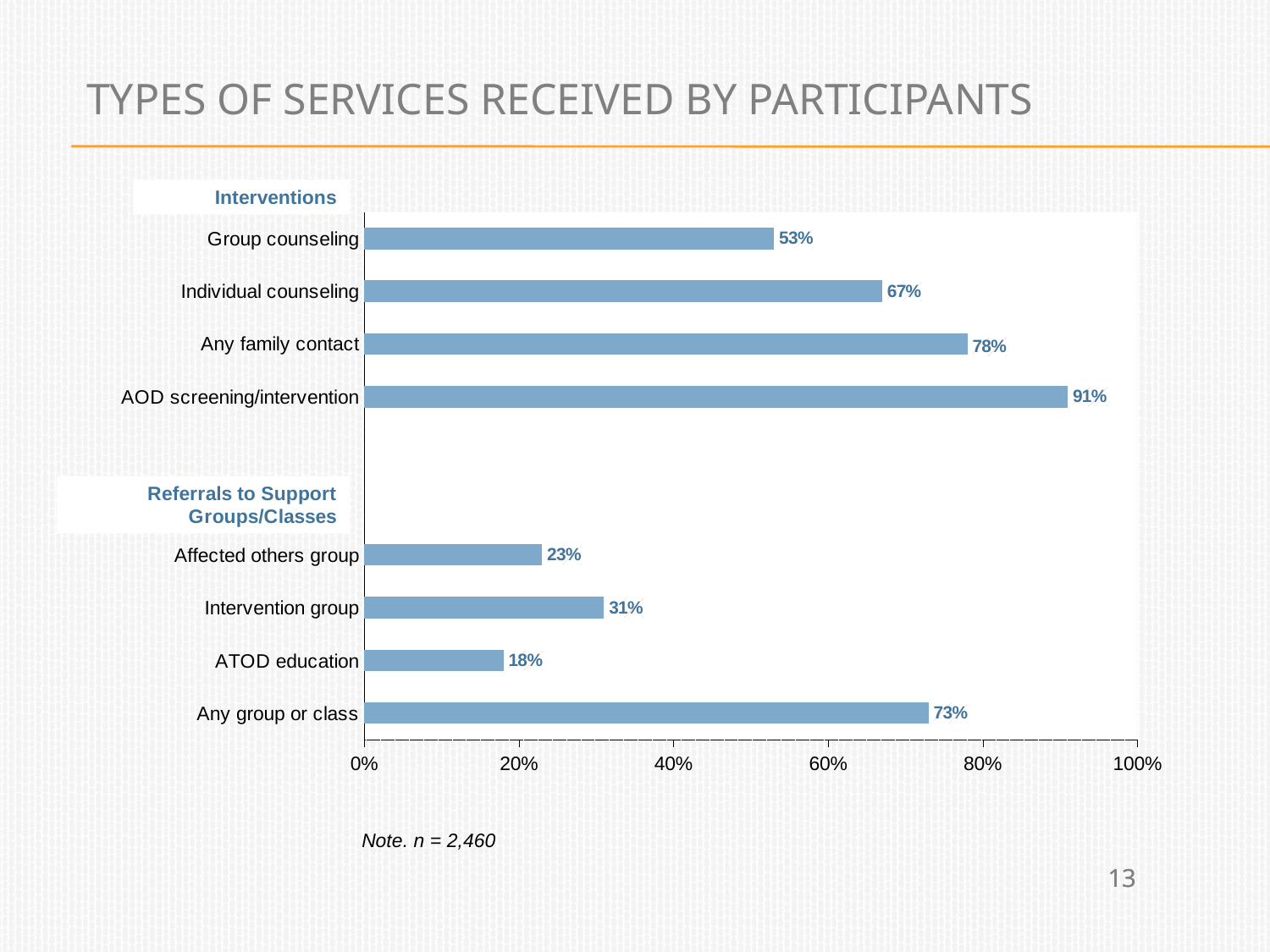
How many service categories are plotted in the chart? 8 Which service category has the highest percentage? AOD screening/intervention What is the difference between Any family contact and Individual counseling? 11% Which service category has the lowest percentage? ATOD education What is the value for Any group or class? 73% Which is larger, Intervention group or Affected others group? Intervention group What sample size is given in the note below the chart? n = 2,460 Is the value for Individual counseling greater or less than 60%? greater What percentage of participants received group counseling? 53% What is the value shown for AOD screening/intervention? 91% What percentage of participants received ATOD education? 18% What kind of chart is shown on the slide? Bar chart